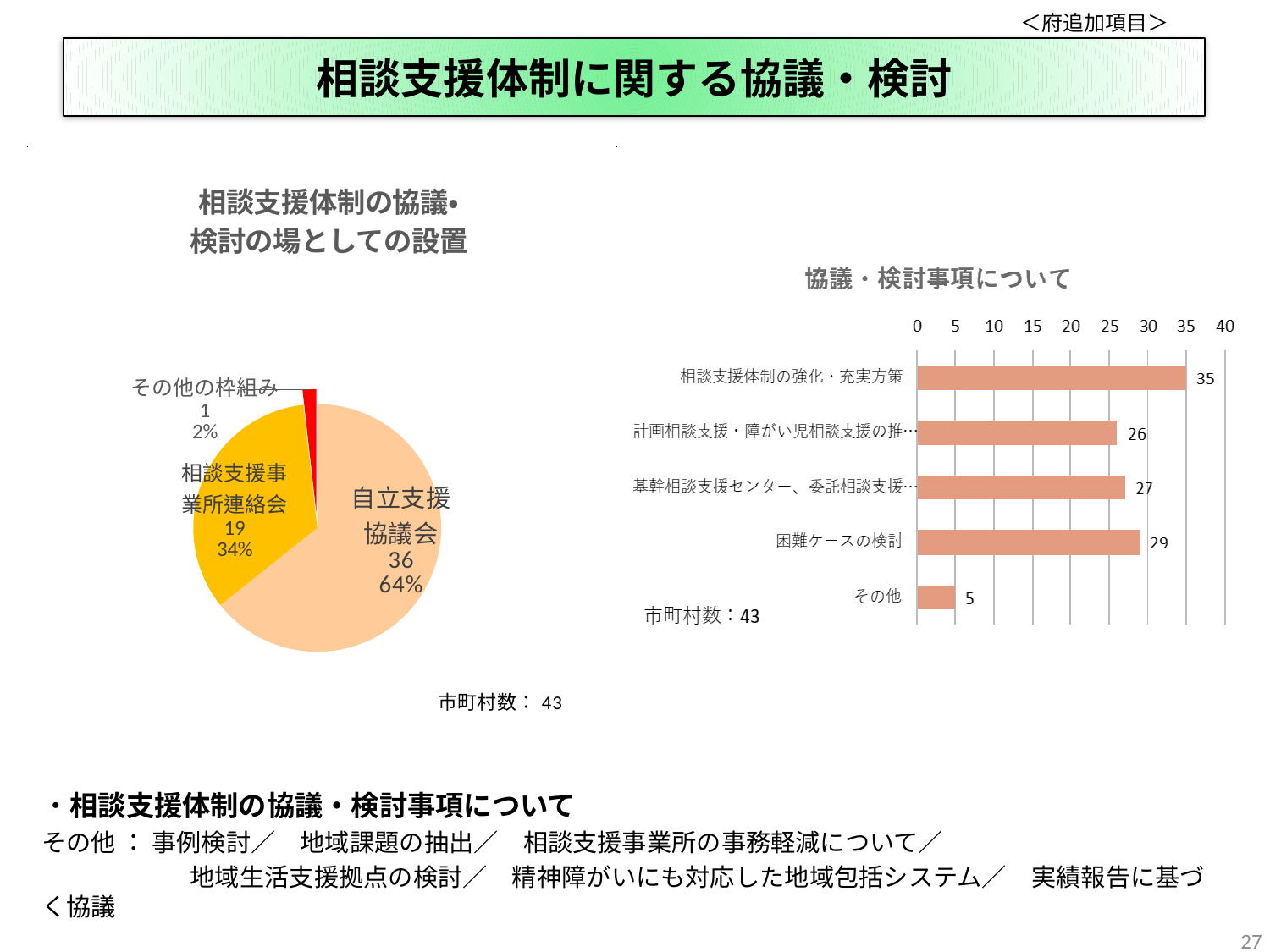
In the pie chart titled 相談支援体制の協議•検討の場としての設置, what percentage share does その他の枠組み have? 2% In the bar chart titled 協議・検討事項について, which category has the highest value? 相談支援体制の強化・充実方策 In the pie chart titled 相談支援体制の協議•検討の場としての設置, what percentage share does 相談支援事業所連絡会 have? 34% What kind of chart is the chart titled 協議・検討事項について? bar chart In the pie chart titled 相談支援体制の協議•検討の場としての設置, how many slices are there? 3 In the pie chart titled 相談支援体制の協議•検討の場としての設置, which category has the largest slice? 自立支援協議会 In the pie chart titled 相談支援体制の協議•検討の場としての設置, what is the difference between the values for 自立支援協議会 and 相談支援事業所連絡会? 17 In the bar chart titled 協議・検討事項について, what is the value for 相談支援体制の強化・充実方策? 35 In the bar chart titled 協議・検討事項について, how many categories are shown? 5 In the bar chart titled 協議・検討事項について, what is the value for 困難ケースの検討? 29 In the pie chart titled 相談支援体制の協議•検討の場としての設置, what value is shown for 自立支援協議会? 36 In the bar chart titled 協議・検討事項について, which category has the lowest value? その他